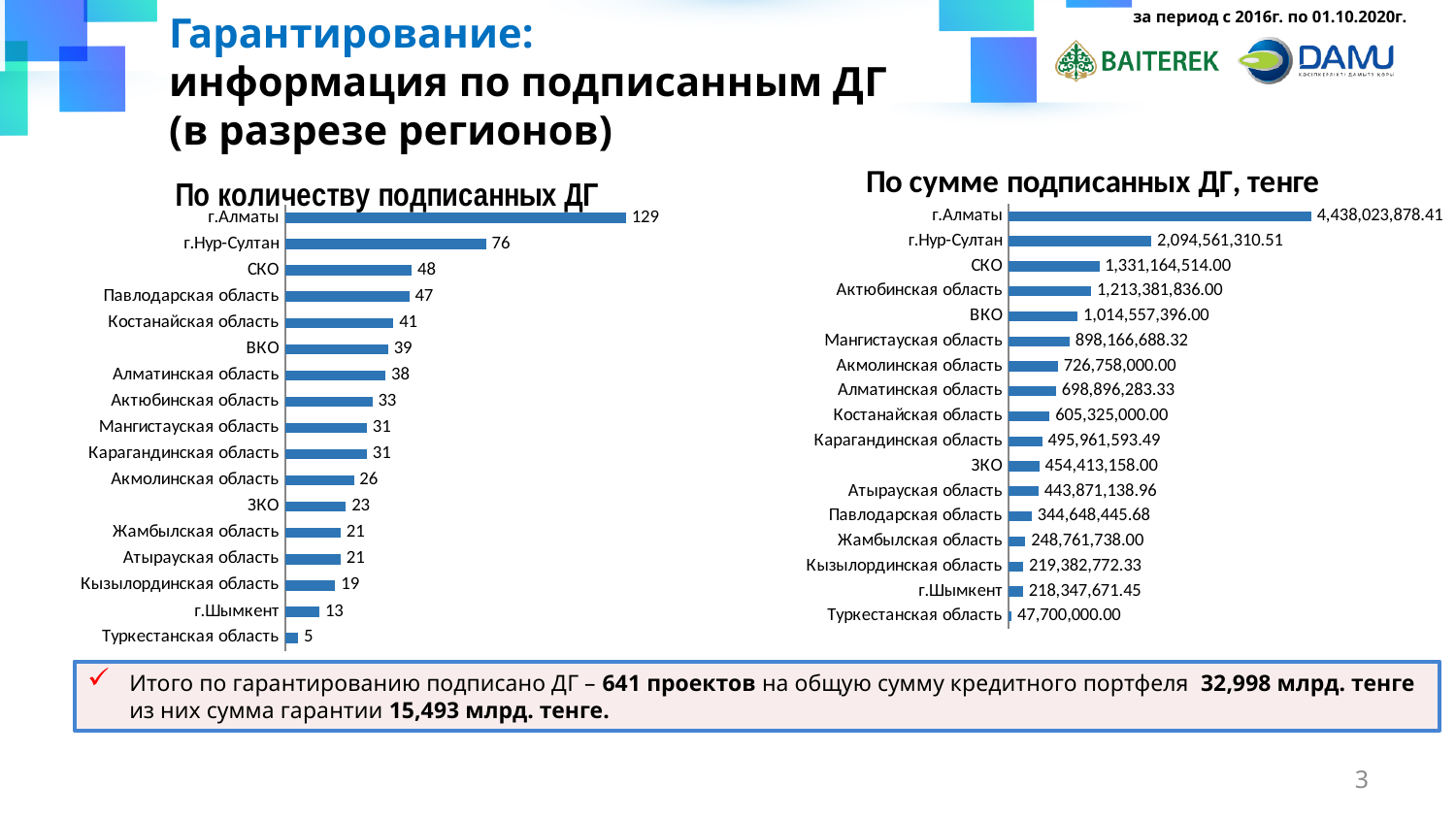
In the chart 'По количеству подписанных ДГ', which is larger, the value for ВКО or the value for Акмолинская область? ВКО In the chart 'По сумме подписанных ДГ, тенге', which region has the highest value? г.Алматы In the chart 'По сумме подписанных ДГ, тенге', which is larger, the value for Актюбинская область or the value for ВКО? Актюбинская область In the chart 'По количеству подписанных ДГ', what is the difference between г.Алматы and г.Нур-Султан? 53 What is the title of the chart on the left side of the slide? По количеству подписанных ДГ In the chart 'По количеству подписанных ДГ', how many regions are shown? 17 In the chart 'По количеству подписанных ДГ', what is the value for г.Алматы? 129 In the chart 'По сумме подписанных ДГ, тенге', what is the value for СКО? 1,331,164,514.00 In the chart 'По количеству подписанных ДГ', what is the value for Павлодарская область? 47 What type of chart is 'По сумме подписанных ДГ, тенге'? Bar chart In the chart 'По сумме подписанных ДГ, тенге', what is the value for г.Шымкент? 218,347,671.45 In the chart 'По количеству подписанных ДГ', which region has the lowest value? Туркестанская область